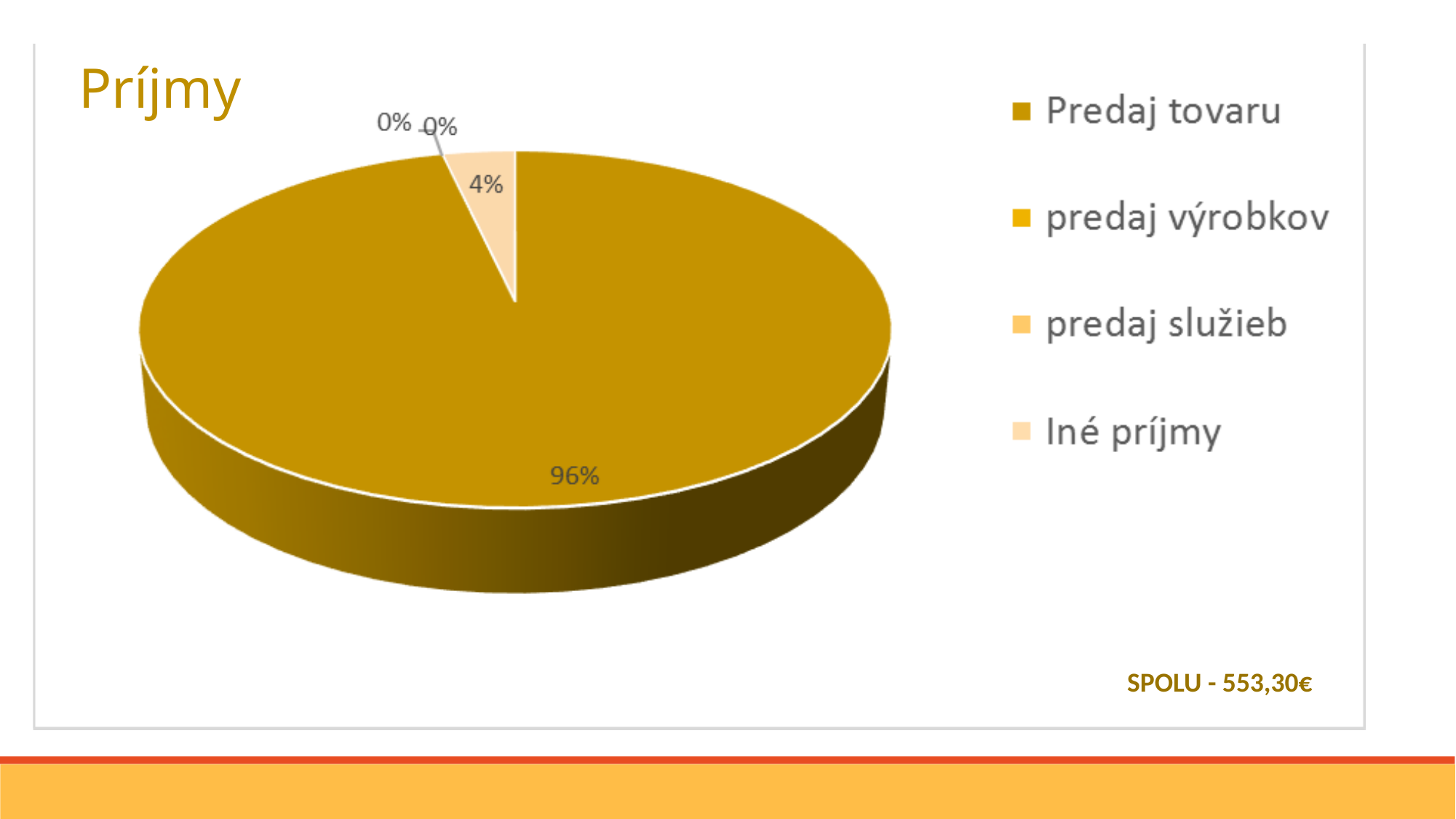
Which legend entry is listed last? Iné príjmy What share of the pie does Predaj tovaru take? 96% How many slices are labelled 0%? 2 What is the largest percentage label shown on the pie? 96% What is the difference between the 96% slice and the 4% slice? 92% Which category has the largest share of the pie? Predaj tovaru What kind of chart is shown on the slide? pie chart How many categories does the legend list? 4 Is the share for Predaj tovaru greater or less than 50%? greater What total amount (SPOLU) is shown on the slide? 553,30€ What is the title of the chart? Príjmy What is the second-largest percentage label shown on the pie? 4%